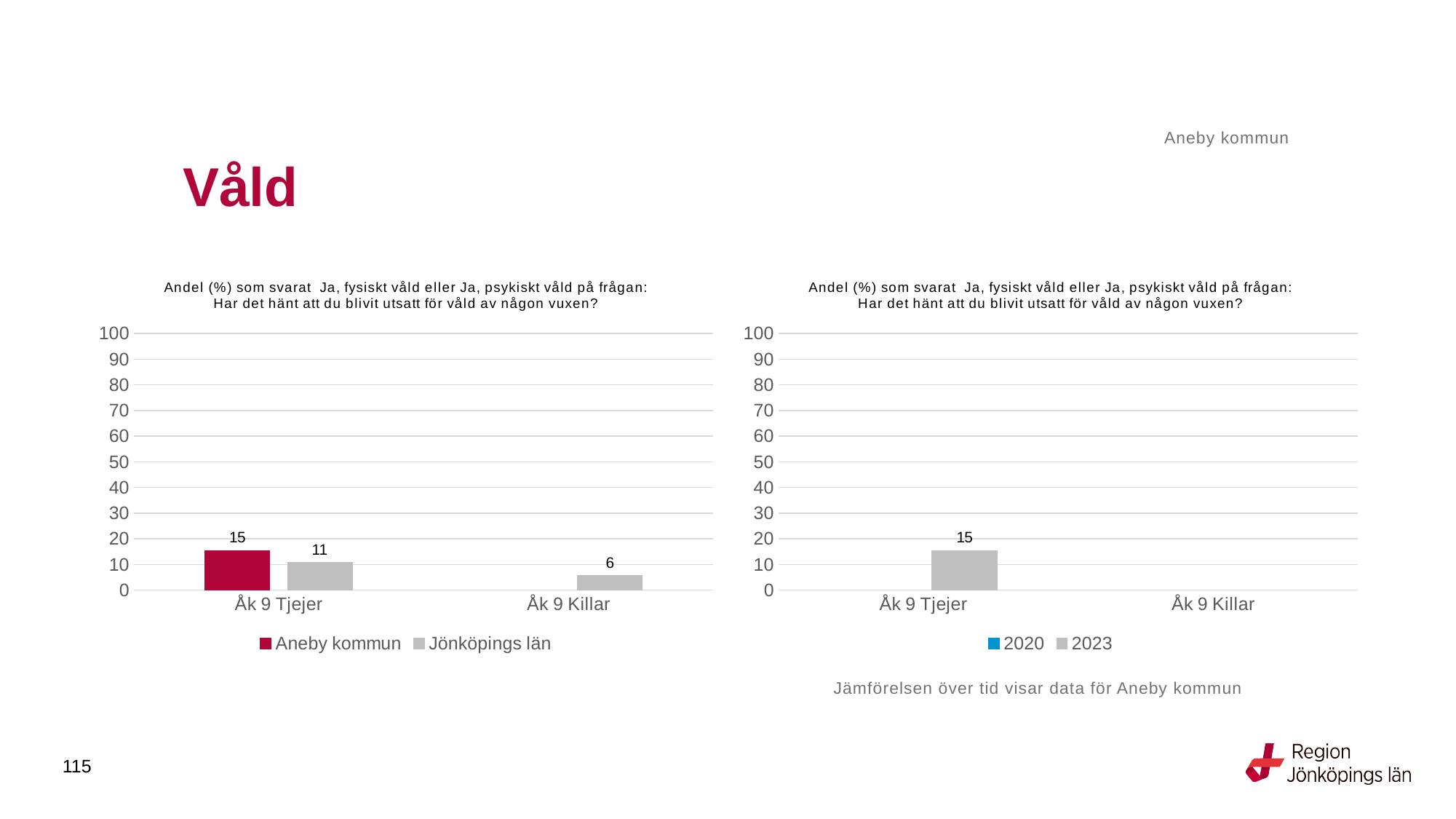
In the left chart, what is the difference between Aneby kommun and Jönköpings län for Åk 9 Tjejer? 4 In the left chart, what is the value for Aneby kommun for Åk 9 Tjejer? 15 In the left chart, what is the value for Jönköpings län for Åk 9 Killar? 6 Which two years are listed in the legend of the right chart? 2020 and 2023 In the left chart, is the value for Aneby kommun for Åk 9 Tjejer greater or less than 20? less How many series does the legend of the left chart list? 2 What kind of chart is the right chart? Bar chart In the left chart, which is larger for Åk 9 Tjejer: Aneby kommun or Jönköpings län? Aneby kommun In the left chart, what is the value for Jönköpings län for Åk 9 Tjejer? 11 In the right chart, what is the value for 2023 for Åk 9 Tjejer? 15 How many categories are shown on the x axis of the right chart? 2 In the left chart, which category has the lowest value for Jönköpings län? Åk 9 Killar